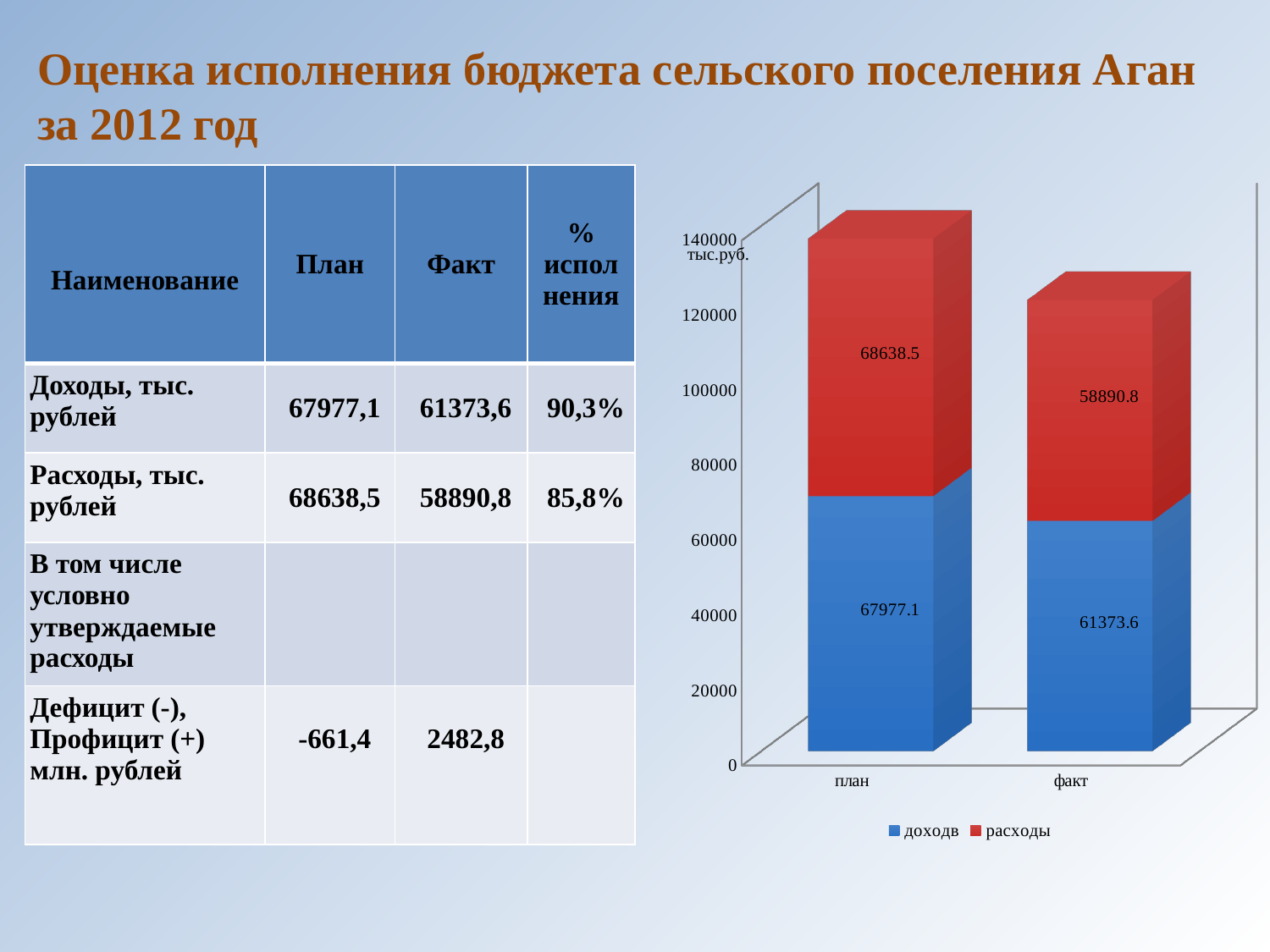
Which colour represents расходы in the chart? red Which is larger in the chart: расходы for план or расходы for факт? расходы for план In the chart, what is the value of расходы for факт? 58890.8 In the chart, what is the value of доходв for план? 67977.1 What is the total of the stacked bar for план? 136615.6 What kind of chart is shown on the slide? stacked bar chart How many series does the chart legend list? 2 What is the total of the stacked bar for факт? 120264.4 In the chart, what is the value of расходы for план? 68638.5 In the chart, what is the value of доходв for факт? 61373.6 How many categories are shown on the x axis of the chart? 2 What is the difference between доходв for план and доходв for факт? 6603.5